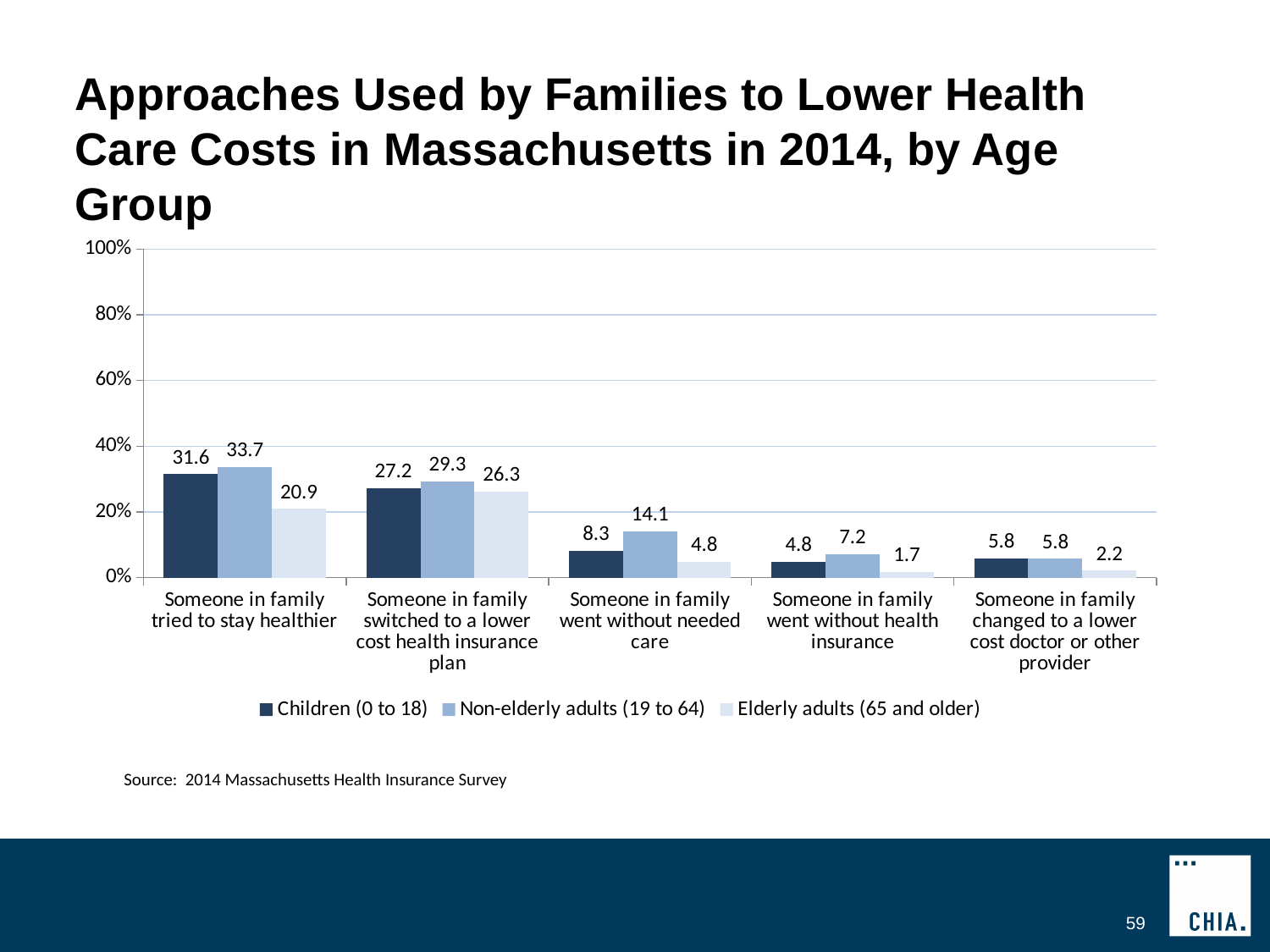
What is the value for Non-elderly adults (19 to 64) in the 'Someone in family went without needed care' category? 14.1 How many series does the legend list? 3 Which category has the lowest value for Elderly adults (65 and older)? Someone in family went without health insurance How many categories are shown on the x axis? 5 What is the difference between the Non-elderly adults (19 to 64) and Children (0 to 18) values in the 'Someone in family went without needed care' category? 5.8 What is the value for Children (0 to 18) in the 'Someone in family tried to stay healthier' category? 31.6 What is the source cited below the chart? 2014 Massachusetts Health Insurance Survey Which category has the highest value for Non-elderly adults (19 to 64)? Someone in family tried to stay healthier Is the value for Children (0 to 18) in the 'Someone in family tried to stay healthier' category greater or less than 40%? less What is the value for Elderly adults (65 and older) in the 'Someone in family went without health insurance' category? 1.7 What kind of chart is shown on the slide? bar chart In the 'Someone in family switched to a lower cost health insurance plan' category, which is larger: the value for Children (0 to 18) or for Elderly adults (65 and older)? Children (0 to 18)